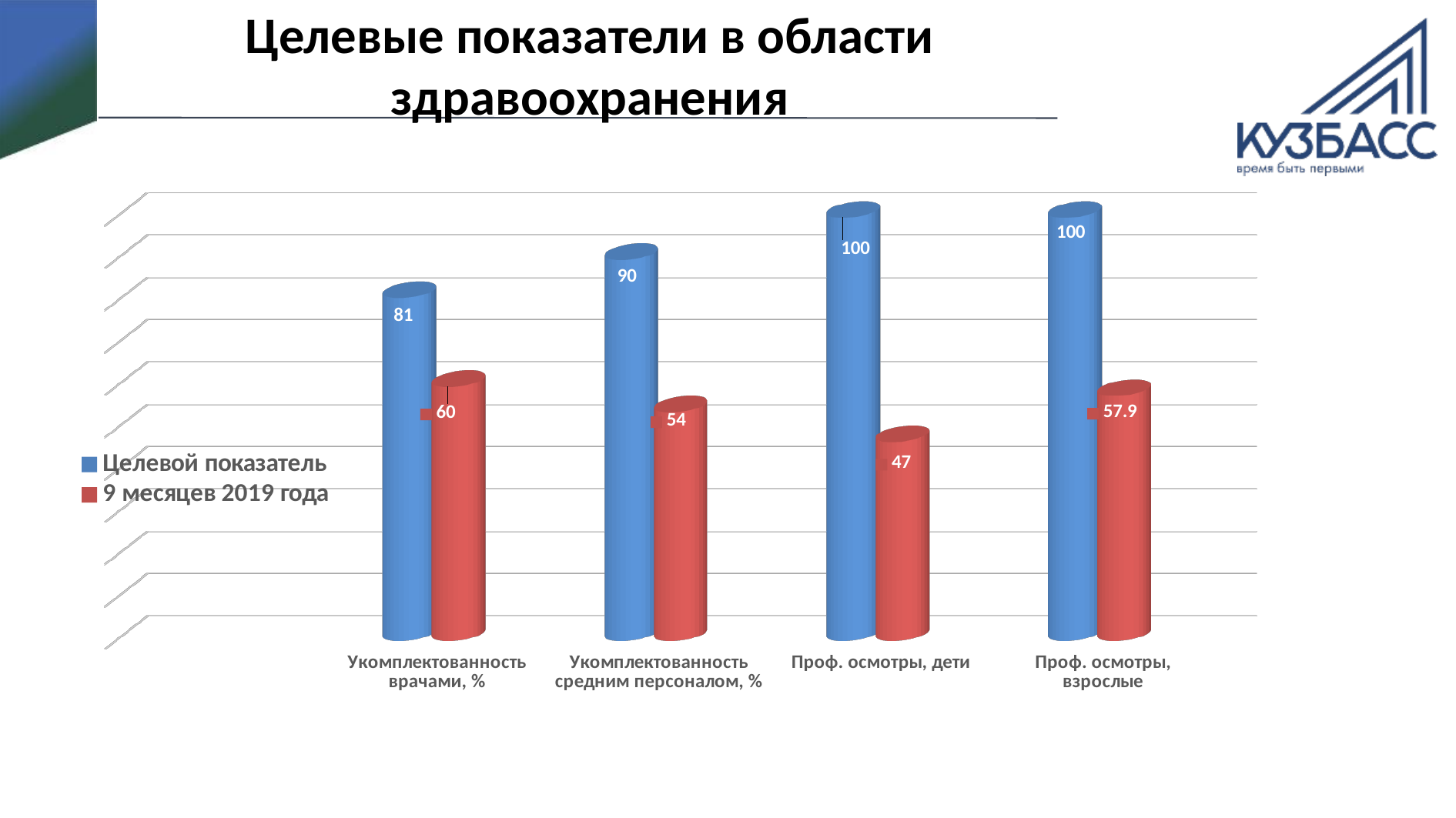
What is the difference between "Целевой показатель" and "9 месяцев 2019 года" for "Укомплектованность врачами, %"? 21 What is the value of "Целевой показатель" for "Проф. осмотры, дети"? 100 What is the value of "Целевой показатель" for "Укомплектованность врачами, %"? 81 What kind of chart is shown on the slide? Bar chart How many series does the legend list? 2 What is the value of "9 месяцев 2019 года" for "Проф. осмотры, взрослые"? 57.9 Which category has the lowest value for "9 месяцев 2019 года"? Проф. осмотры, дети What is the value of "9 месяцев 2019 года" for "Укомплектованность средним персоналом, %"? 54 How many categories are shown on the x axis? 4 What is the difference between "Целевой показатель" and "9 месяцев 2019 года" for "Проф. осмотры, дети"? 53 Which category has the highest value for "9 месяцев 2019 года"? Укомплектованность врачами, % Which is larger: "9 месяцев 2019 года" for "Укомплектованность врачами, %" or for "Укомплектованность средним персоналом, %"? Укомплектованность врачами, %